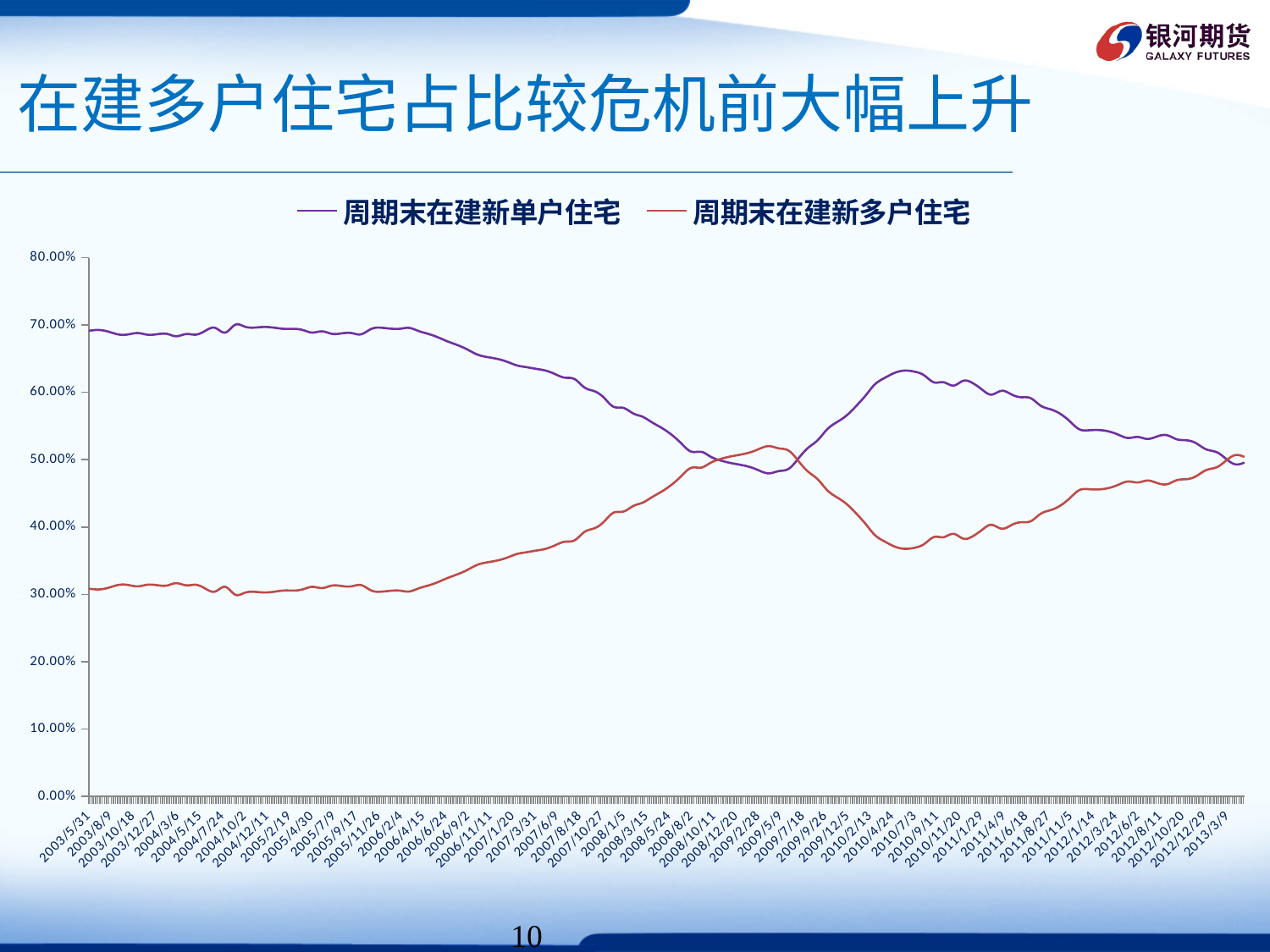
Does the 周期末在建新多户住宅 line overall rise or fall from 2003/5/31 to 2013/3/9? rise Is the value for 周期末在建新单户住宅 at 2010/7/3 greater or less than 60.00%? greater Does the 周期末在建新单户住宅 line overall rise or fall from 2003/5/31 to 2013/3/9? fall Is the value for 周期末在建新多户住宅 at 2003/5/31 greater or less than 40.00%? less What colour is the line for 周期末在建新多户住宅? red At 2003/5/31, which series has the higher value, 周期末在建新单户住宅 or 周期末在建新多户住宅? 周期末在建新单户住宅 What are the two series named in the legend? 周期末在建新单户住宅 and 周期末在建新多户住宅 What kind of chart is shown on the slide? line chart Is the value for 周期末在建新单户住宅 at 2006/2/4 greater or less than 60.00%? greater How many series does the legend list? 2